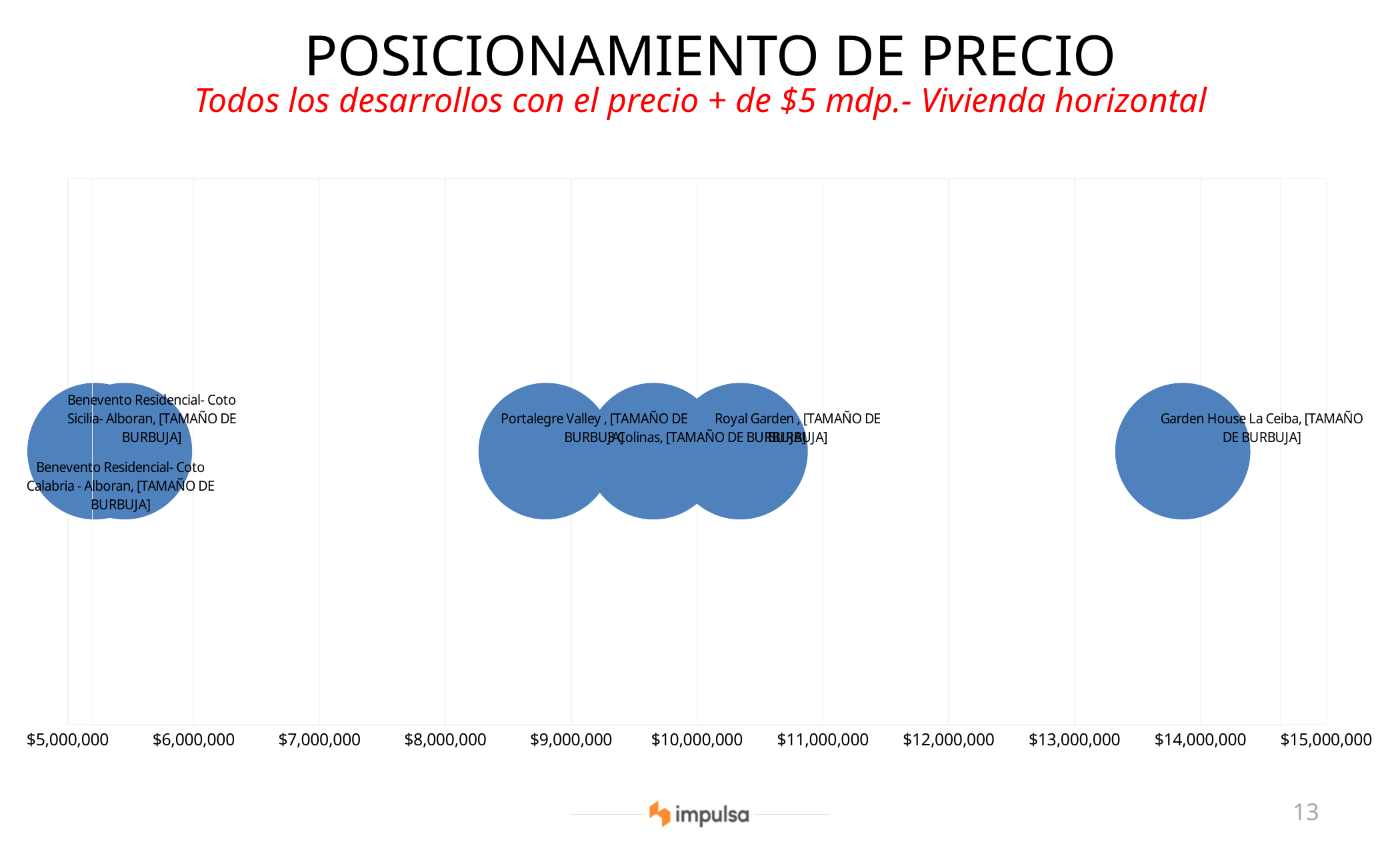
How many developments (bubbles) are plotted on the chart? 6 Which is positioned at a higher price, Royal Garden or Portalegre Valley? Royal Garden Is the price for Garden House La Ceiba greater or less than $13,000,000? greater Is the price for Colinas greater or less than $10,000,000? less What kind of chart is shown on the slide? Bubble chart Are the Benevento Residencial bubbles positioned at prices greater or less than $6,000,000? less What are the lowest and highest values shown on the chart's x axis? $5,000,000 and $15,000,000 What is the title of the slide containing the chart? POSICIONAMIENTO DE PRECIO Which is positioned at a higher price, Garden House La Ceiba or Royal Garden? Garden House La Ceiba Which development is positioned at the highest price on the chart? Garden House La Ceiba